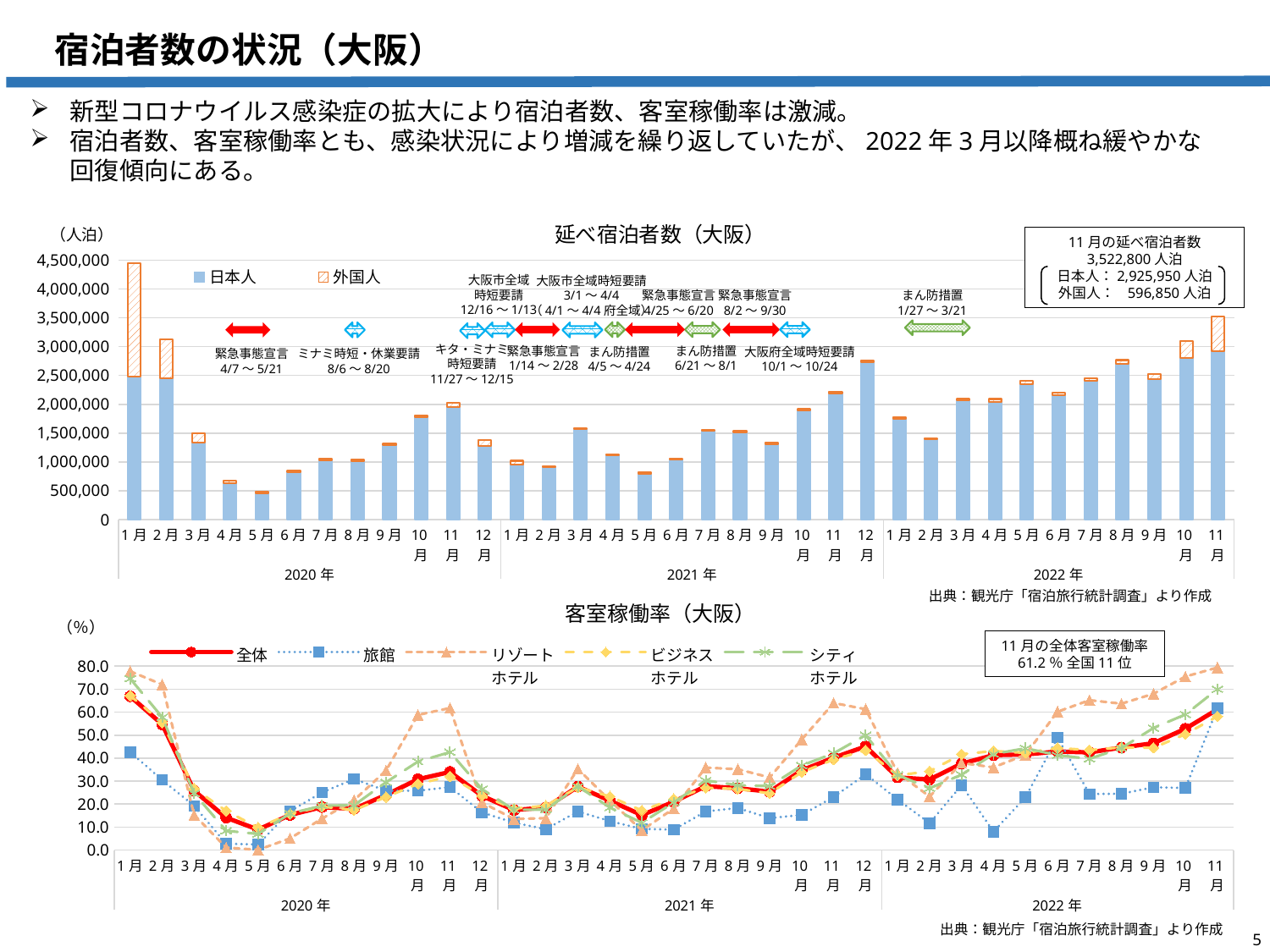
In the top chart 延べ宿泊者数（大阪）, which month has the highest total bar? 2020年1月 In the top chart 延べ宿泊者数（大阪）, is the total bar for 2020年1月 greater or less than 4,000,000? greater In the bottom chart 客室稼働率（大阪）, is the 全体 value for 2020年1月 greater or less than 60.0? greater In the bottom chart 客室稼働率（大阪）, does the 全体 line generally rise or fall from 2022年3月 to 2022年11月? rise In the top chart 延べ宿泊者数（大阪）, what is the 日本人 value for 2022年11月 as stated in the annotation box? 2,925,950人泊 In the top chart 延べ宿泊者数（大阪）, what is the 外国人 value for 2022年11月 as stated in the annotation box? 596,850人泊 In the bottom chart 客室稼働率（大阪）, how many series does the legend list? 5 In the top chart 延べ宿泊者数（大阪）, what is the total number of overnight stays for 2022年11月 as stated in the annotation box? 3,522,800人泊 What kind of chart is the top chart titled 延べ宿泊者数（大阪）? bar chart In the bottom chart 客室稼働率（大阪）, what is the 全体 occupancy rate for 2022年11月 as stated in the annotation box? 61.2% In the top chart 延べ宿泊者数（大阪）, how many series does the legend list? 2 In the top chart 延べ宿泊者数（大阪）, which month has the lowest total bar? 2020年5月